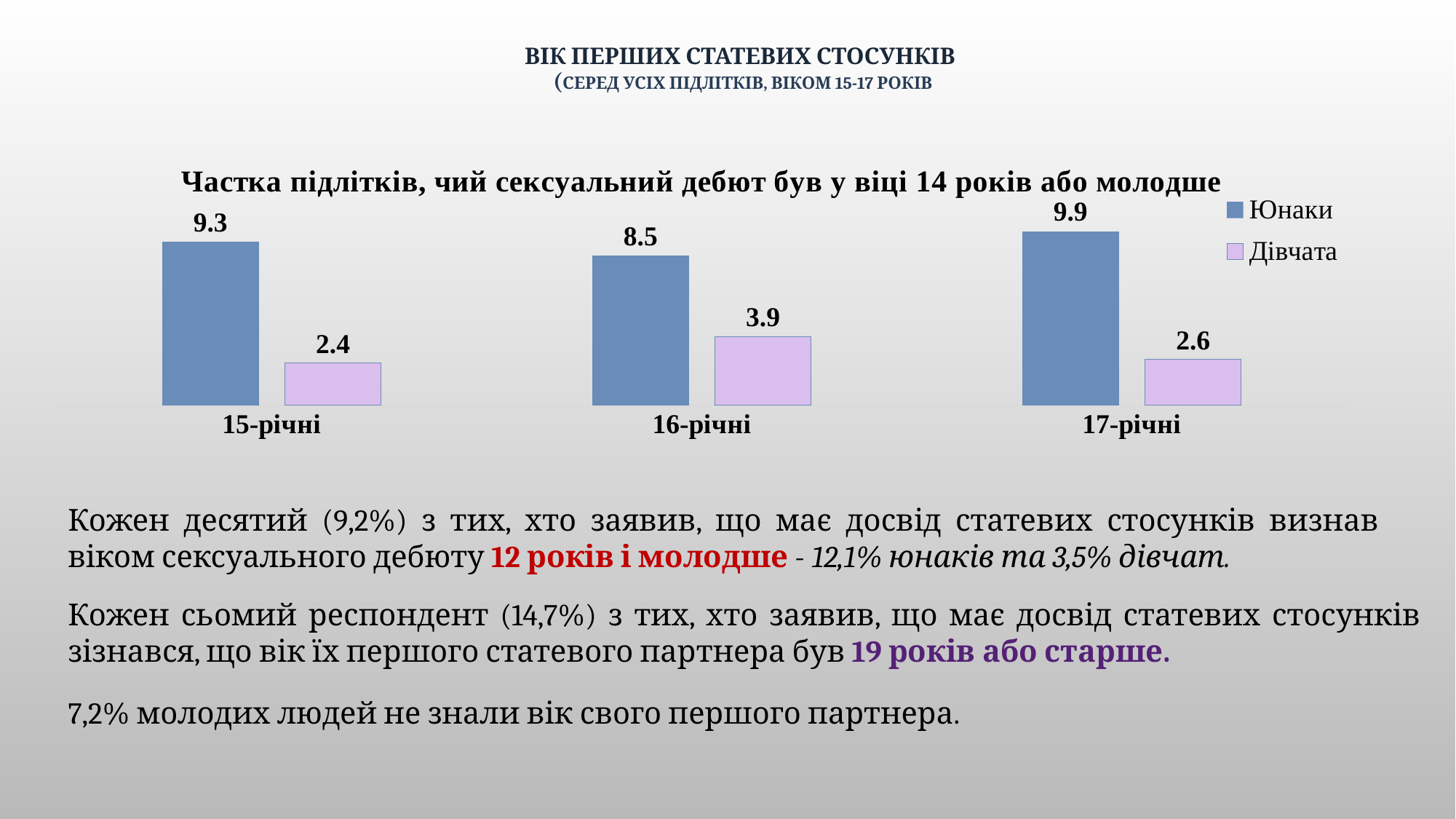
Which is larger: the Дівчата value for 16-річні or for 17-річні? 16-річні How many age groups are shown on the x axis? 3 What is the difference between the Юнаки and Дівчата values among 16-річні? 4.6 Which age group has the highest value for Юнаки? 17-річні What kind of chart is shown on the slide? Bar chart What is the value for Дівчата among 15-річні? 2.4 What is the title of the chart? Частка підлітків, чий сексуальний дебют був у віці 14 років або молодше What is the value for Юнаки among 15-річні? 9.3 What is the value for Дівчата among 16-річні? 3.9 What is the value for Юнаки among 17-річні? 9.9 How many series does the legend list? 2 Which age group has the lowest value for Дівчата? 15-річні